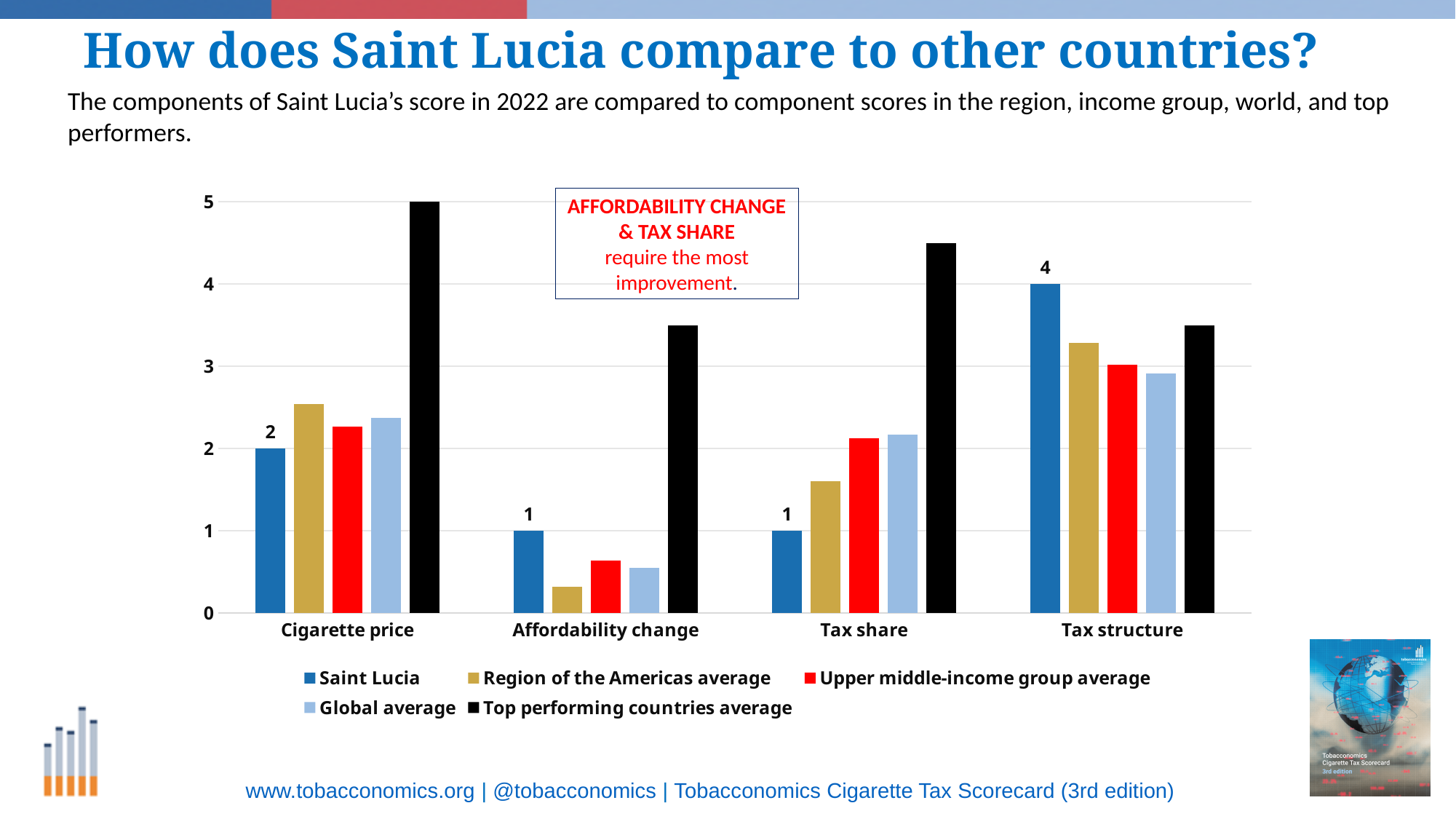
What is the Top performing countries average for Cigarette price? 5 What is the difference between Saint Lucia's Tax structure score and its Cigarette price score? 2 What is Saint Lucia's score for Tax structure? 4 In which component does Saint Lucia have its highest score? Tax structure For Cigarette price, which is larger: Saint Lucia or the Region of the Americas average? Region of the Americas average What kind of chart is shown on the slide? bar chart Is the Top performing countries average for Tax share greater or less than 4? greater How many series does the legend list? 5 What is Saint Lucia's score for Affordability change? 1 Is the Region of the Americas average for Affordability change greater or less than 1? less What is Saint Lucia's score for Cigarette price? 2 How many component categories are shown on the x axis? 4